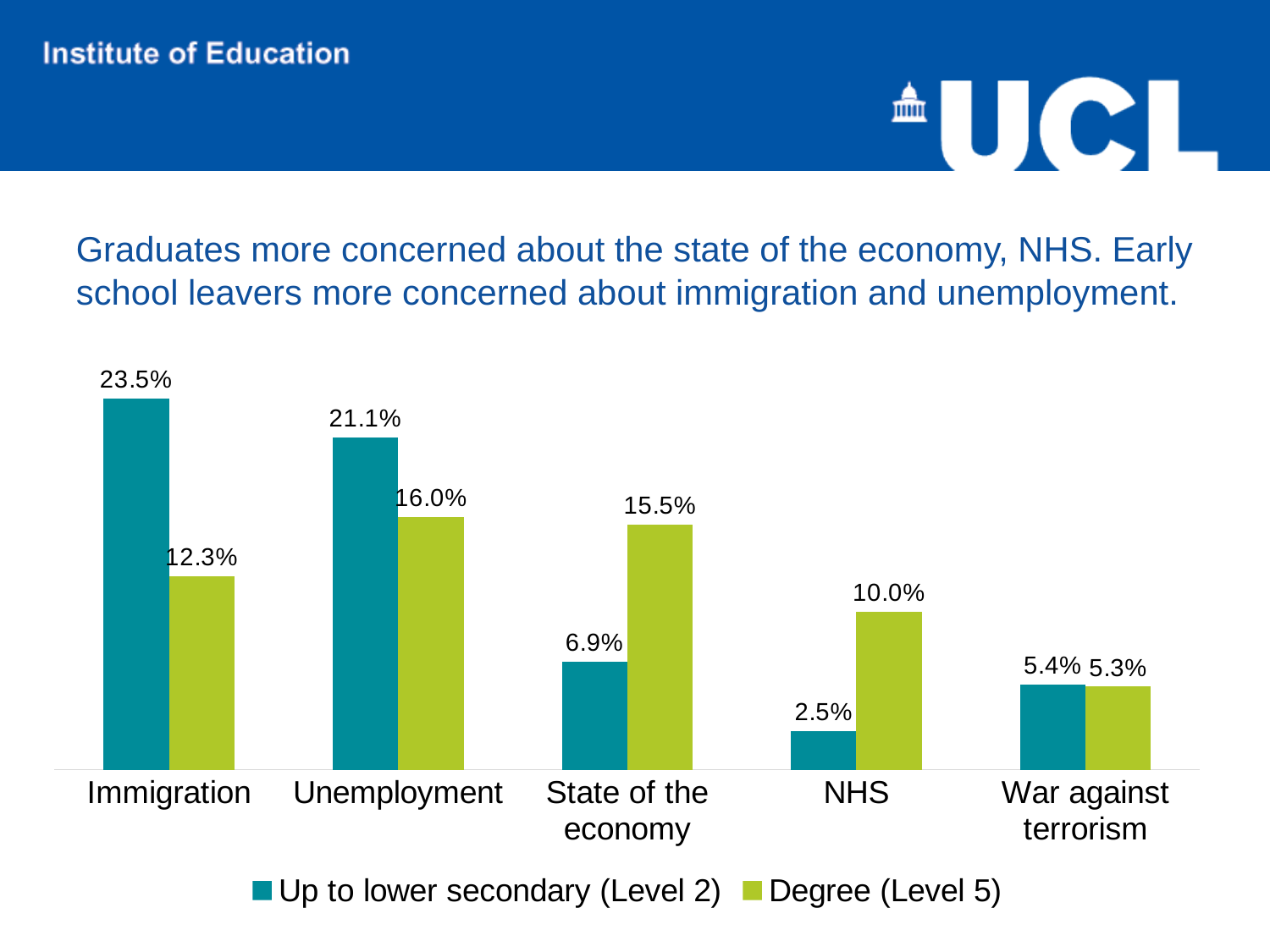
What is the difference between the Degree (Level 5) and Up to lower secondary (Level 2) values for State of the economy? 8.6% Which category has the lowest value in the Degree (Level 5) series? War against terrorism What kind of chart is shown on the slide? Bar chart How many series does the legend list? 2 How many categories are shown on the x axis? 5 Which category has the lowest value in the Up to lower secondary (Level 2) series? NHS What is the value for Immigration in the Up to lower secondary (Level 2) series? 23.5% What is the value for NHS in the Degree (Level 5) series? 10.0% What is the value for State of the economy in the Up to lower secondary (Level 2) series? 6.9% For Unemployment, which series has the larger value: Up to lower secondary (Level 2) or Degree (Level 5)? Up to lower secondary (Level 2) What is the difference between the Up to lower secondary (Level 2) and Degree (Level 5) values for Immigration? 11.2% Which category has the highest value in the Up to lower secondary (Level 2) series? Immigration